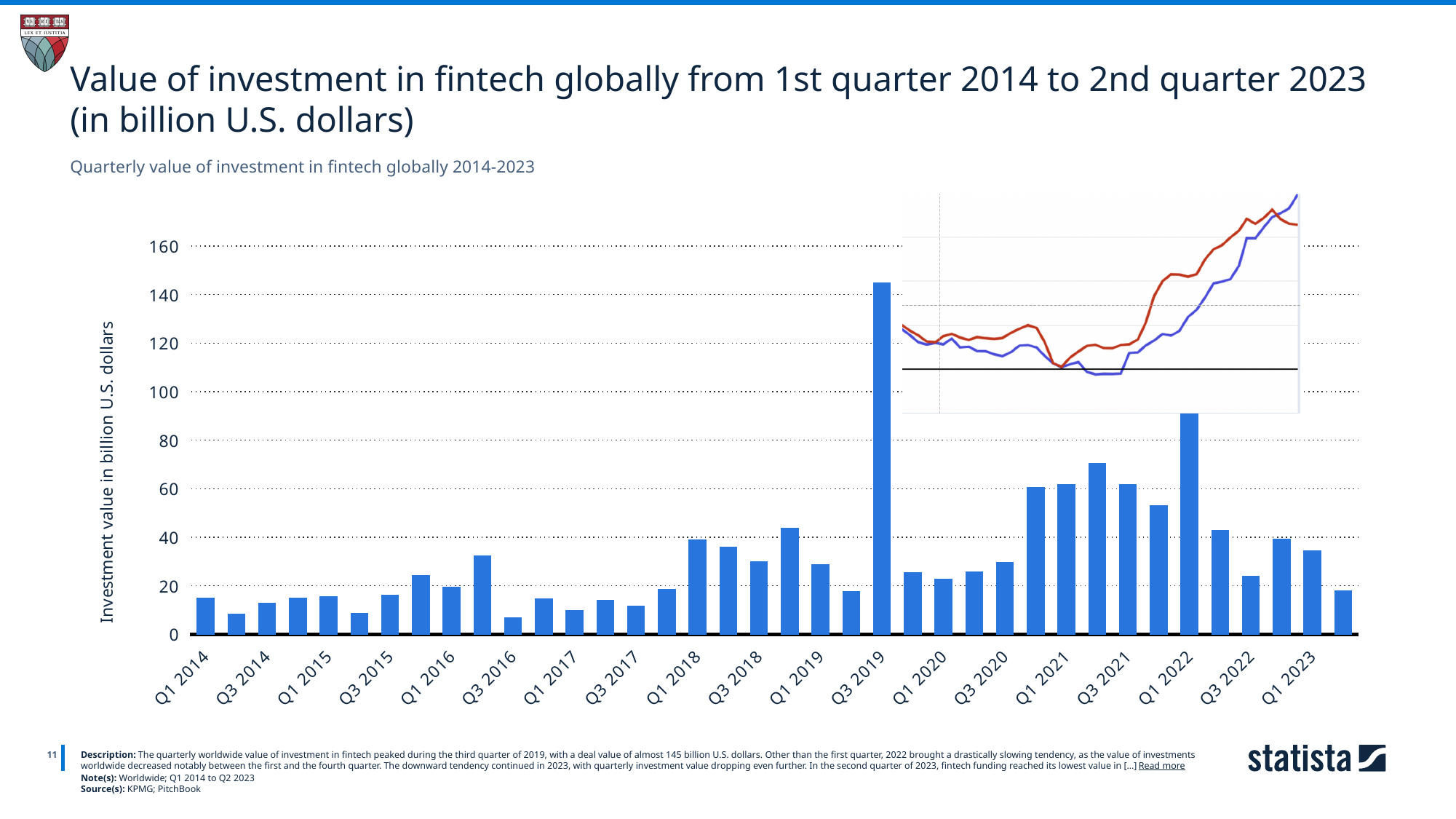
Do the values rise or fall from Q1 2022 to Q1 2023? Fall Is the value for Q1 2022 greater or less than 80? greater Is the value for Q1 2019 greater or less than 20? greater What is the label of the vertical axis? Investment value in billion U.S. dollars How many quarters are plotted as bars in the chart? 38 Which quarter has the highest value of fintech investment? Q3 2019 Which is larger, the value for Q1 2022 or the value for Q1 2021? Q1 2022 Is the value for Q3 2016 greater or less than 20? less Which is larger, the value for Q1 2014 or the value for Q3 2016? Q1 2014 What kind of chart is used to show the quarterly fintech investment values? Bar chart